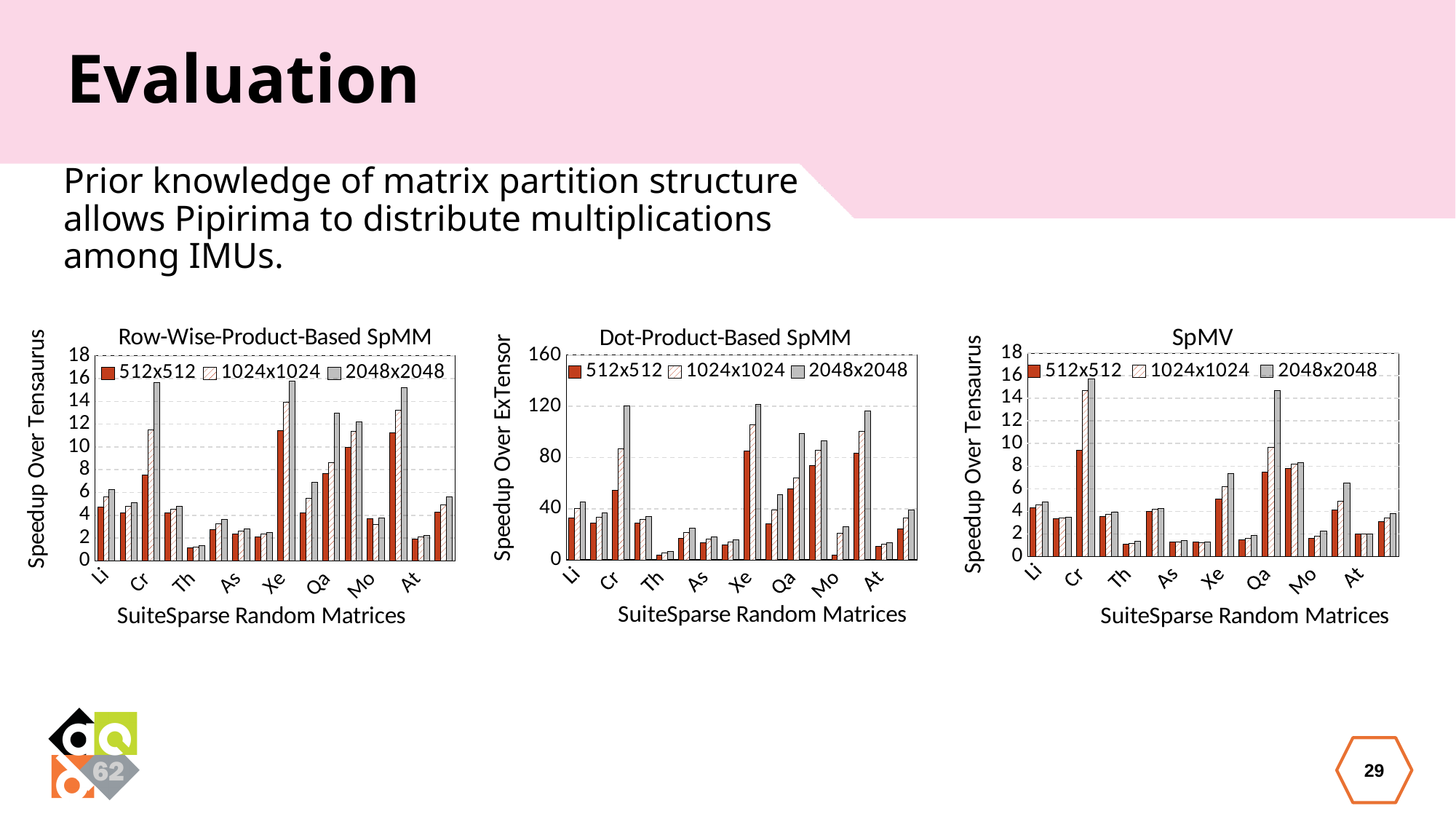
In the Row-Wise-Product-Based SpMM chart, is the 512x512 value for Th greater or less than 2? less In the Row-Wise-Product-Based SpMM chart, what is the x-axis label? SuiteSparse Random Matrices In the Row-Wise-Product-Based SpMM chart, is the 2048x2048 value for Cr greater or less than 14? greater In the Dot-Product-Based SpMM chart, is the 512x512 value for Li greater or less than 40? less In the Row-Wise-Product-Based SpMM chart, which is larger for the 512x512 series: Cr or Li? Cr In the SpMV chart, which is larger for the 512x512 series: Cr or Qa? Cr In the Dot-Product-Based SpMM chart, what is the y-axis label? Speedup Over ExTensor What kind of chart is the Row-Wise-Product-Based SpMM chart? bar chart How many series does the legend of the SpMV chart list? 3